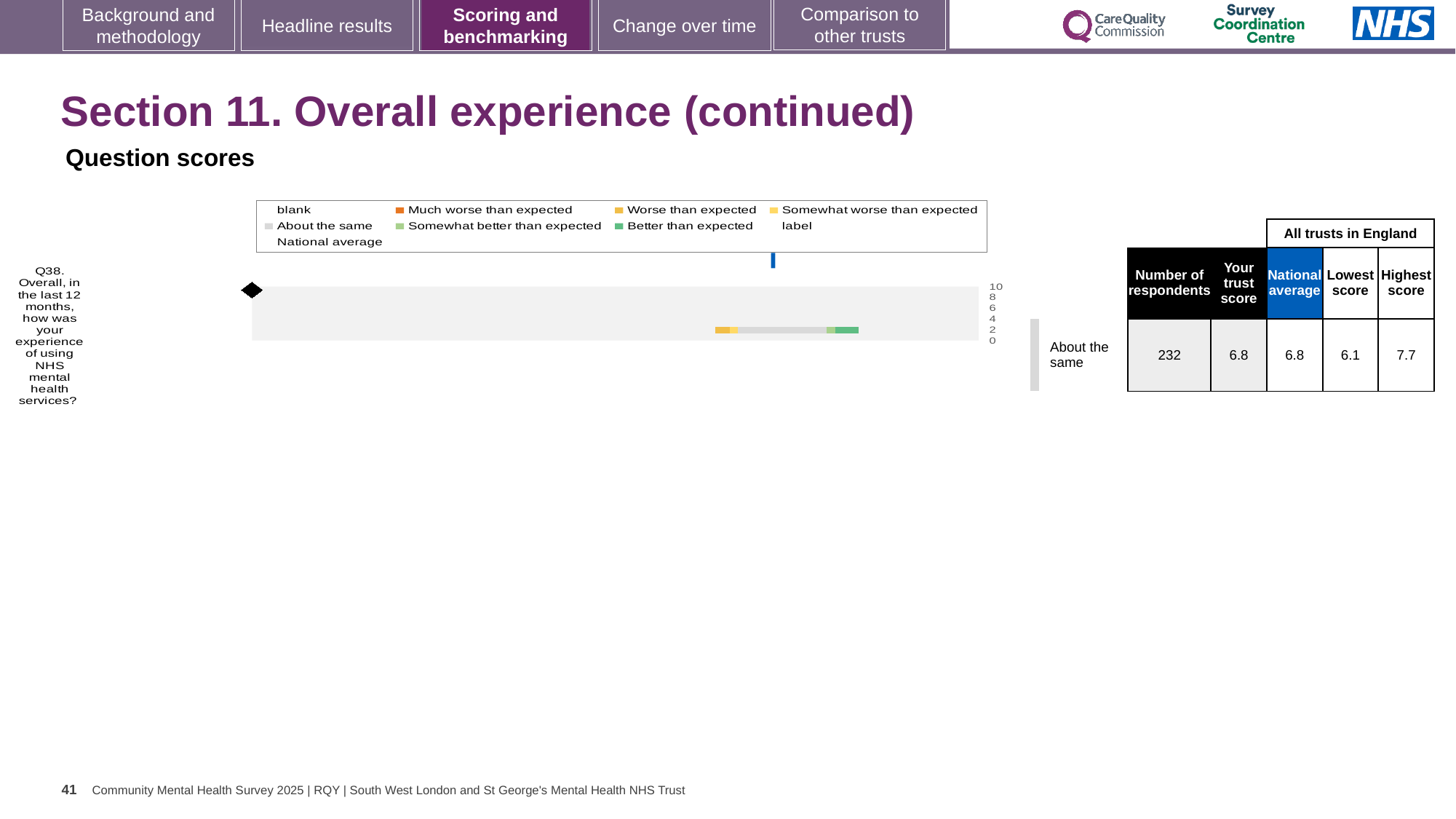
Is the trust's score for Q38 greater or less than the lowest score in England? greater What is the lowest score among all trusts in England for Q38? 6.1 What is the trust's score for Q38? 6.8 What is the difference between the highest and lowest trust scores for Q38? 1.6 What kind of chart is shown for Q38 on this slide? bar chart Which question is plotted in the chart on this slide? Q38. Overall, in the last 12 months, how was your experience of using NHS mental health services? What is the highest score among all trusts in England for Q38? 7.7 How many respondents answered Q38? 232 How many survey questions are plotted in the chart on this slide? 1 What is the national average score for Q38? 6.8 In the chart legend, which colour represents 'Better than expected'? green What is the benchmark category shown next to the chart for Q38? About the same